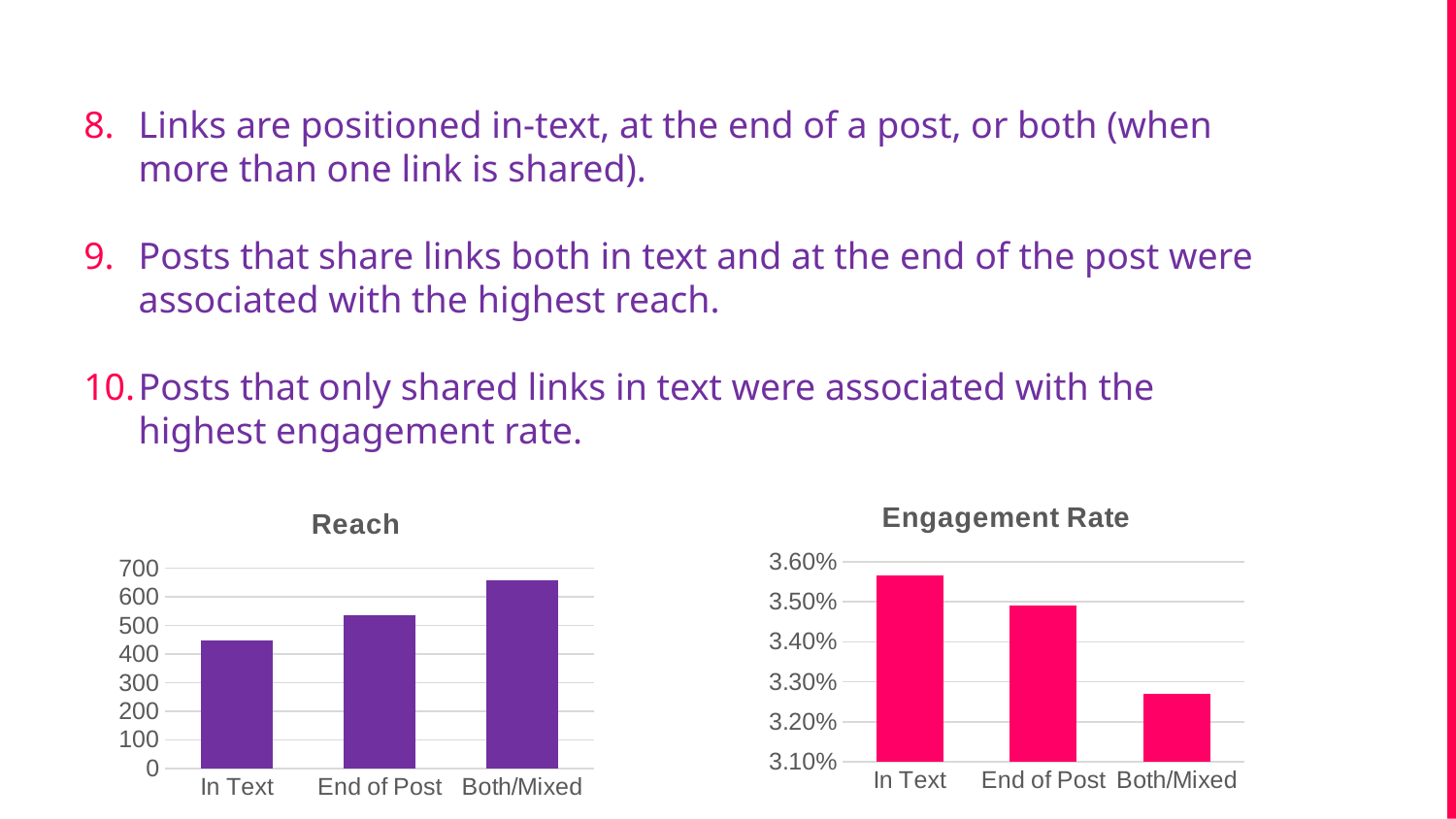
In the Engagement Rate chart, do the values rise or fall from In Text to Both/Mixed? fall In the Engagement Rate chart, which category has the lowest engagement rate? Both/Mixed How many categories are shown in the Reach chart? 3 In the Reach chart, is the value for In Text greater or less than 500? less In the Reach chart, which category has the lowest reach? In Text In the Engagement Rate chart, which category has the highest engagement rate? In Text In the Engagement Rate chart, is the value for In Text greater or less than 3.50%? greater In the Engagement Rate chart, is the value for Both/Mixed greater or less than 3.30%? less In the Reach chart, which is larger, End of Post or In Text? End of Post What kind of chart is the Engagement Rate chart? bar chart In the Reach chart, which category has the highest reach? Both/Mixed